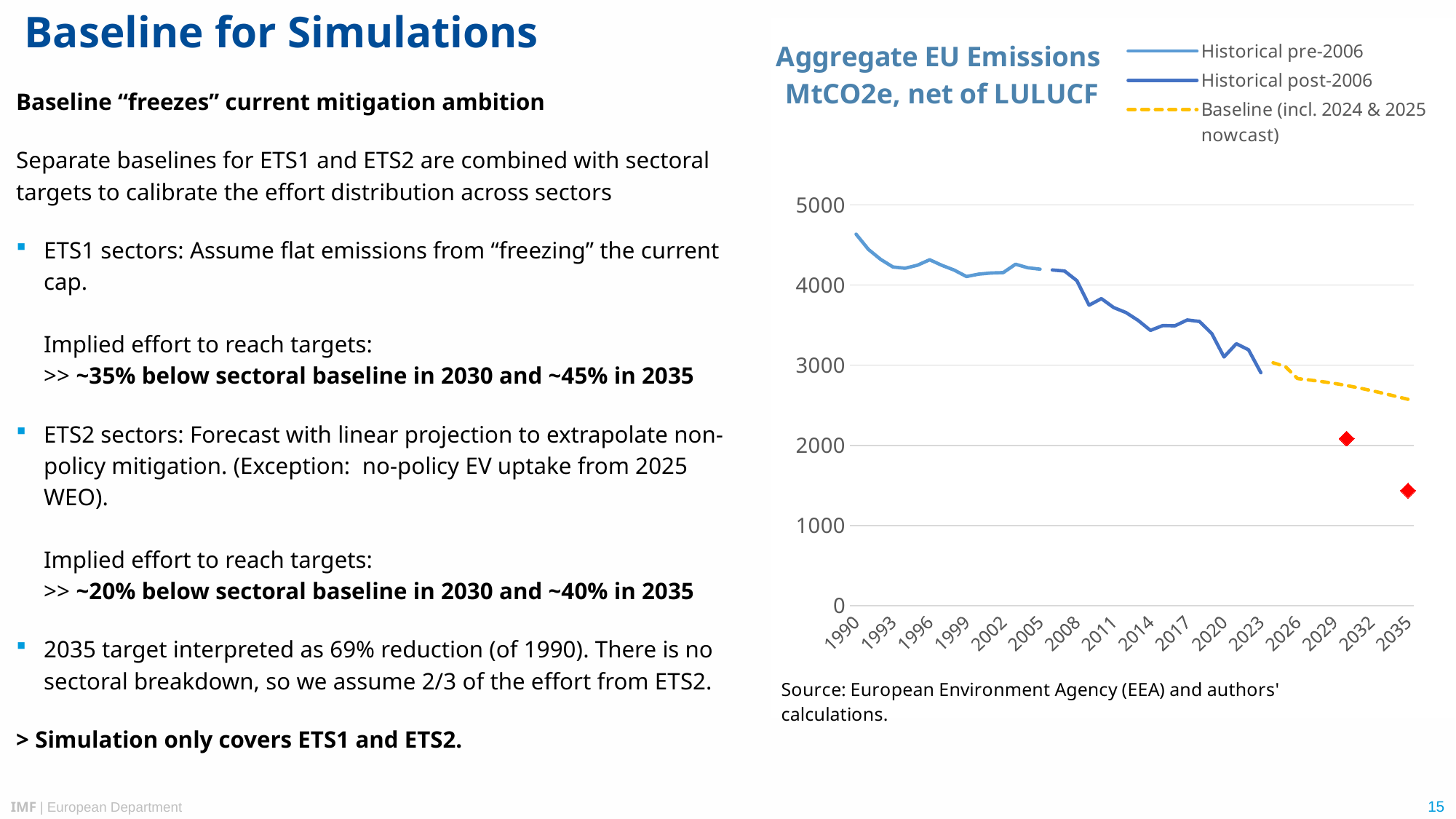
Which legend entry is drawn as a dashed yellow line? Baseline (incl. 2024 & 2025 nowcast) Is the baseline value for 2035 greater or less than 2000? greater Is the baseline value for 2035 greater or less than 3000? less Which year has the highest emissions value on the chart? 1990 Is the value for 2017 greater or less than 3000? greater What is the title of the chart? Aggregate EU Emissions MtCO2e, net of LULUCF What kind of chart is shown on the slide? line chart Do emissions generally rise or fall from 1990 to 2035 along the x axis? fall How many series does the chart legend list? 3